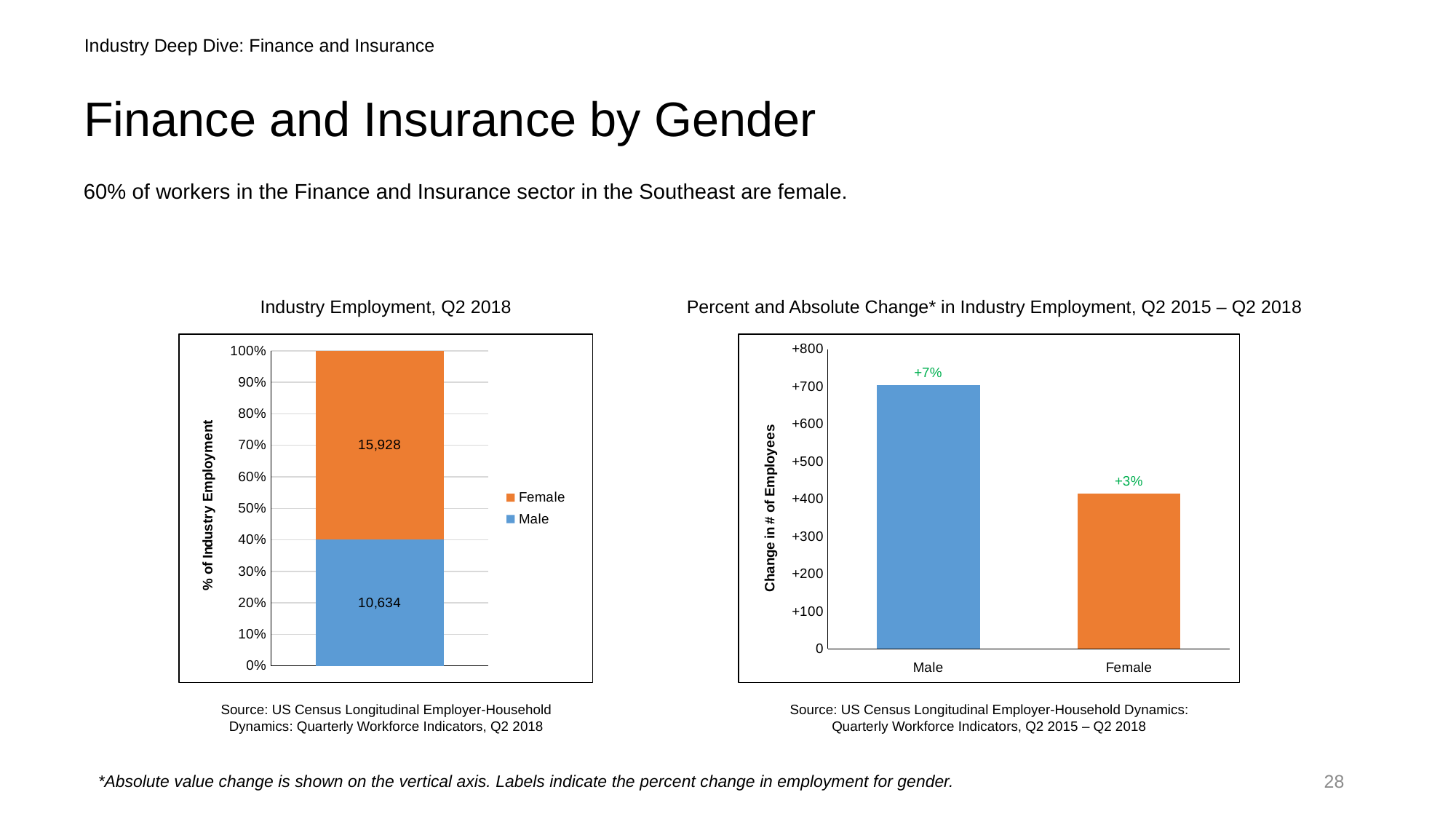
In the 'Percent and Absolute Change in Industry Employment, Q2 2015 – Q2 2018' chart, is the value for Female greater or less than +500? less In the 'Industry Employment, Q2 2018' chart, how many series does the legend list? 2 In the 'Industry Employment, Q2 2018' chart, which segment is larger, Female or Male? Female In the 'Industry Employment, Q2 2018' chart, which colour represents Female? Orange In the 'Industry Employment, Q2 2018' chart, what is the data label on the Male segment? 10,634 What kind of chart is the 'Percent and Absolute Change in Industry Employment, Q2 2015 – Q2 2018' chart? Bar chart In the 'Industry Employment, Q2 2018' chart, what is the difference between the Female and Male labelled values? 5,294 In the 'Industry Employment, Q2 2018' chart, what is the total of the two labelled segments in the stacked bar? 26,562 In the 'Industry Employment, Q2 2018' chart, what is the data label on the Female segment? 15,928 In the 'Percent and Absolute Change in Industry Employment, Q2 2015 – Q2 2018' chart, which category has the highest bar? Male In the 'Percent and Absolute Change in Industry Employment, Q2 2015 – Q2 2018' chart, what percent change label is shown above the Female bar? +3% In the 'Percent and Absolute Change in Industry Employment, Q2 2015 – Q2 2018' chart, what percent change label is shown above the Male bar? +7%